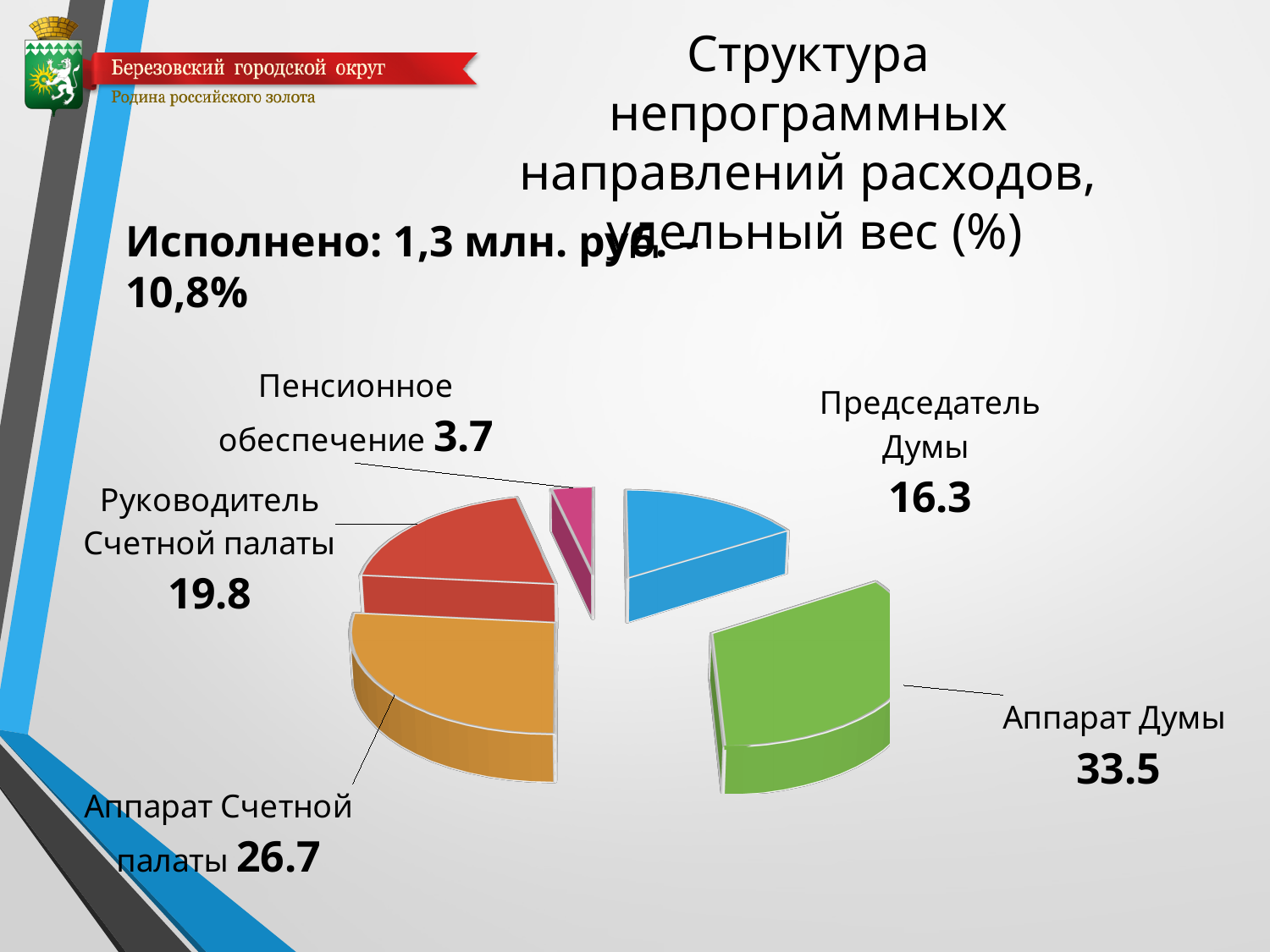
Which category has the smallest slice in the pie chart? Пенсионное обеспечение What is the value for Пенсионное обеспечение in the pie chart? 3.7 What is the value for Председатель Думы in the pie chart? 16.3 What is the value for Руководитель Счетной палаты in the pie chart? 19.8 What kind of chart is shown on the slide? Pie chart Which is larger: the slice for Аппарат Счетной палаты or the slice for Руководитель Счетной палаты? Аппарат Счетной палаты What is the value for Аппарат Думы in the pie chart? 33.5 Which category has the largest slice in the pie chart? Аппарат Думы What colour is the slice for Аппарат Думы? Green How many slices does the pie chart have? 5 What is the difference between the values for Аппарат Думы and Аппарат Счетной палаты? 6.8 What is the difference between the values for Руководитель Счетной палаты and Председатель Думы? 3.5